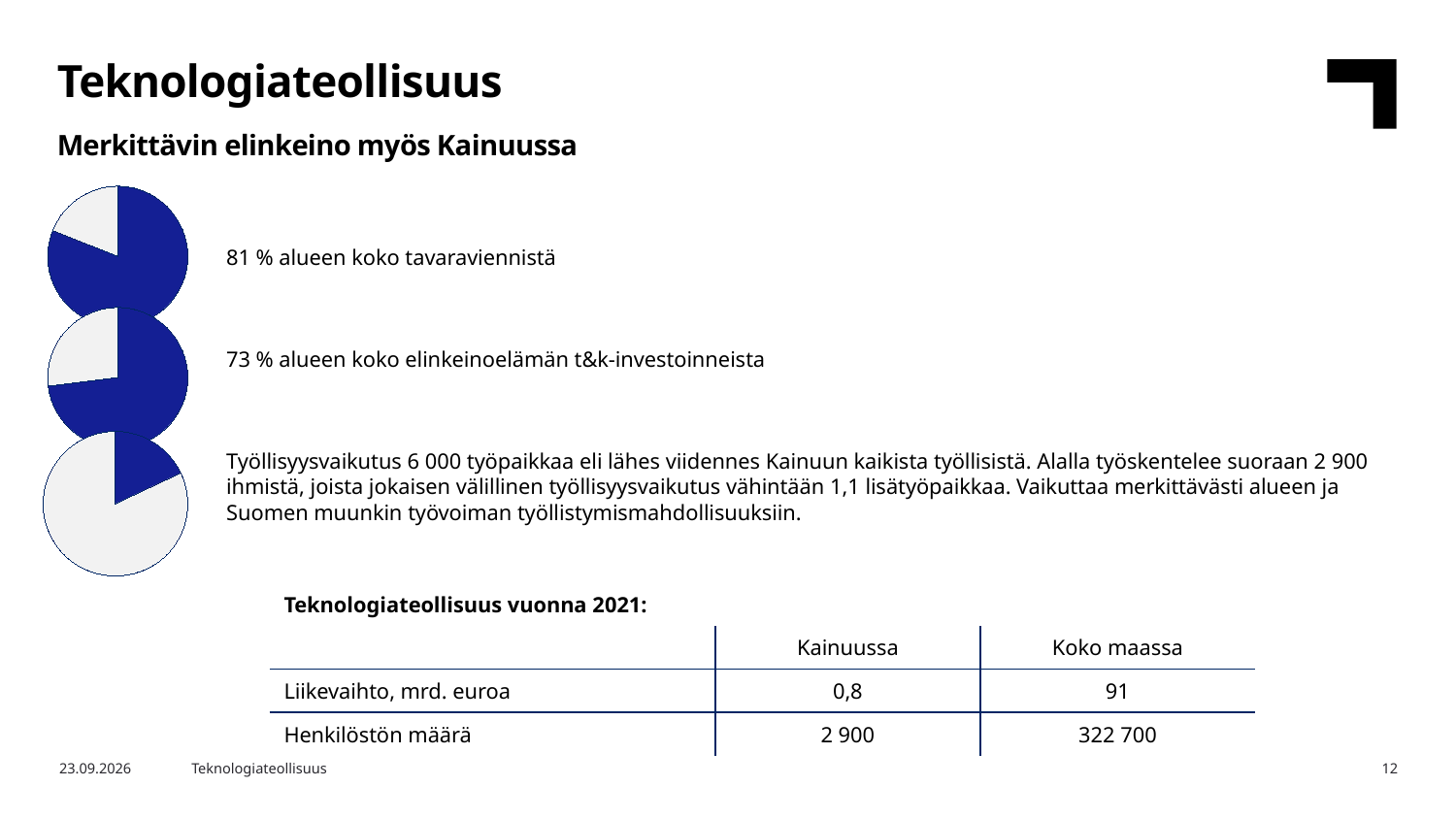
What kind of charts are shown on the left side of the slide? Pie charts In the top pie chart, is the blue slice larger or smaller than the grey slice? Larger How many pie charts are on the slide? 3 In the top pie chart, what share of the region's total goods exports (tavaravienti) does the blue slice represent? 81 % In the middle pie chart, what share of the region's business R&D investments (t&k-investoinnit) does the blue slice represent? 73 % Which pie chart has the largest blue slice: the top, middle or bottom one? Top What is the difference in percentage points between the blue share of the top pie chart (81 %) and the middle pie chart (73 %)? 8 percentage points What is the main title of the slide containing the pie charts? Teknologiateollisuus Is the blue share in the top pie chart (goods exports) larger or smaller than the blue share in the middle pie chart (R&D investments)? Larger Which pie chart has the smallest blue slice: the top, middle or bottom one? Bottom In the bottom pie chart, is the blue slice larger or smaller than the grey slice? Smaller What two colours are used for the slices in the pie charts? Blue and light grey